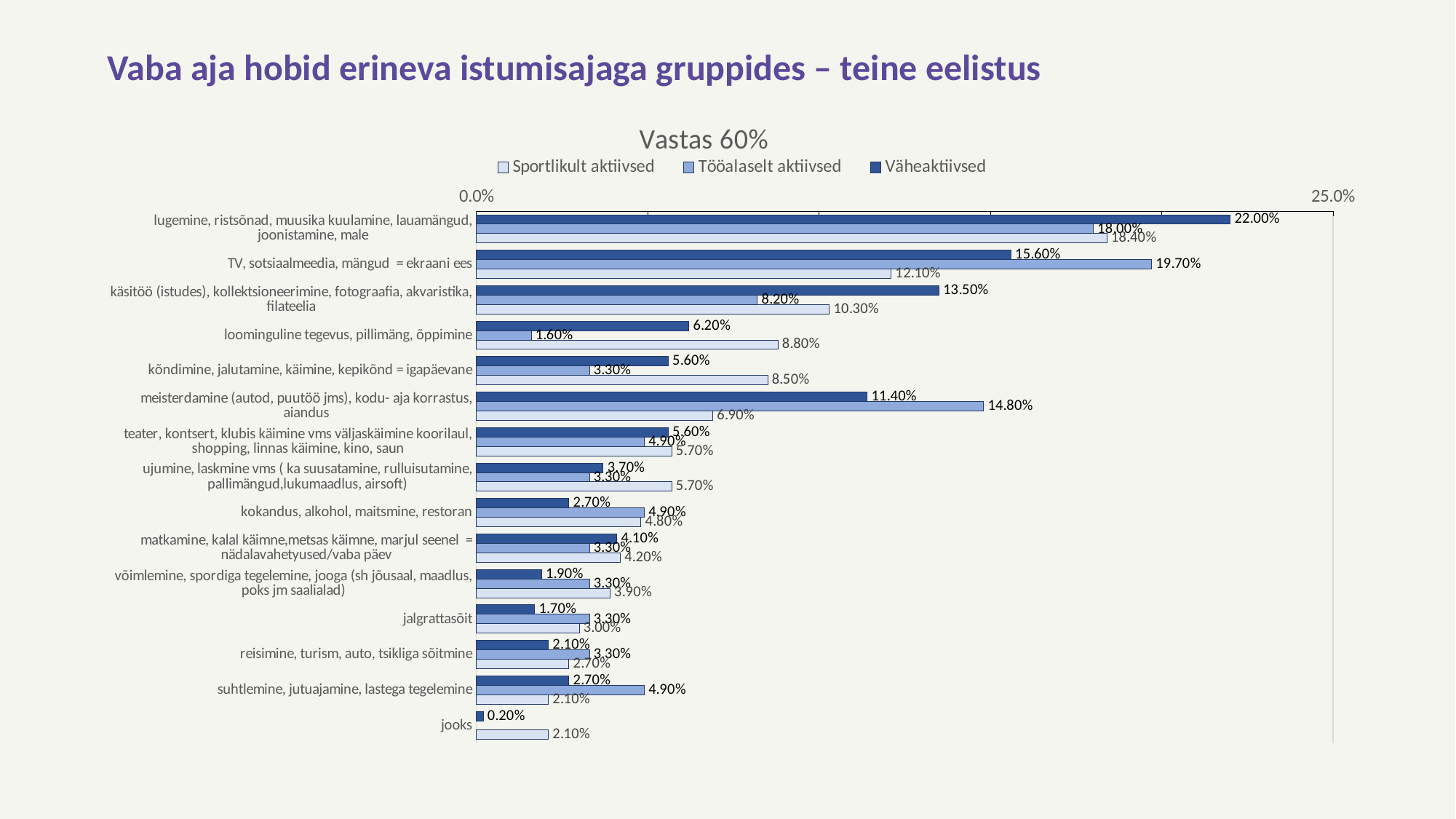
Which category has the lowest value for Väheaktiivsed? jooks What is the value for Väheaktiivsed in the category 'jalgrattasõit'? 1.70% Which category has the highest value for Väheaktiivsed? lugemine, ristsõnad, muusika kuulamine, lauamängud, joonistamine, male What is the difference between the Väheaktiivsed and Tööalaselt aktiivsed values for 'käsitöö (istudes), kollektsioneerimine, fotograafia, akvaristika, filateelia'? 5.30% What is the title of the chart? Vastas 60% What is the value for Sportlikult aktiivsed in the category 'loominguline tegevus, pillimäng, õppimine'? 8.80% What is the value for Sportlikult aktiivsed in the category 'jooks'? 2.10% How many series does the legend list? 3 What is the value for Tööalaselt aktiivsed in the category 'TV, sotsiaalmeedia, mängud = ekraani ees'? 19.70% What is the difference between the Sportlikult aktiivsed and Väheaktiivsed values for 'kõndimine, jalutamine, käimine, kepikõnd = igapäevane'? 2.90% What type of chart is shown on the slide? bar chart For 'meisterdamine (autod, puutöö jms), kodu- aja korrastus, aiandus', which is larger: the Tööalaselt aktiivsed value or the Sportlikult aktiivsed value? Tööalaselt aktiivsed